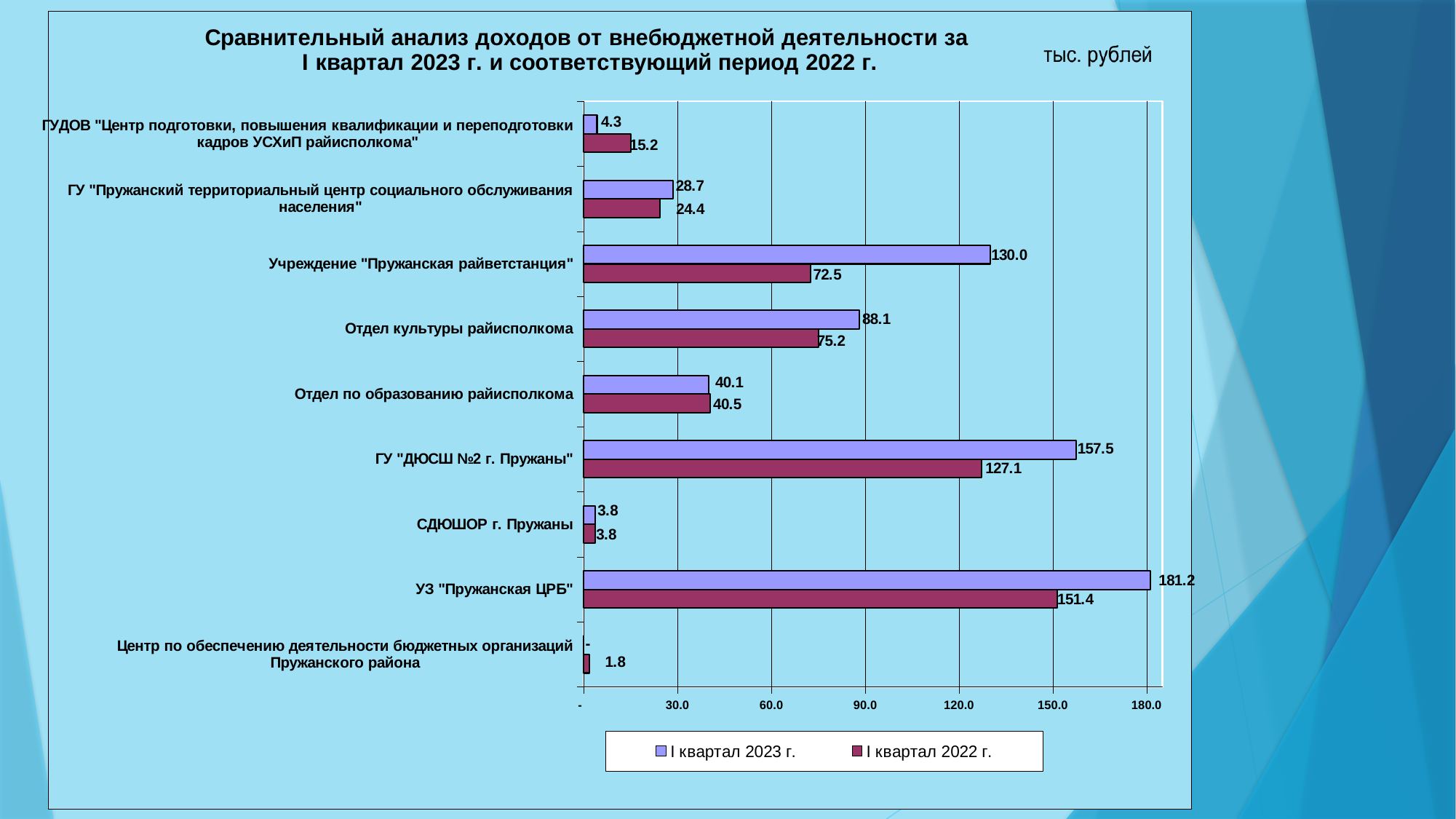
Is the I квартал 2023 г. value for ГУ "ДЮСШ №2 г. Пружаны" greater or less than 150.0? greater What is the value for УЗ "Пружанская ЦРБ" in I квартал 2023 г.? 181.2 What is the difference between the I квартал 2023 г. and I квартал 2022 г. values for Учреждение "Пружанская райветстанция"? 57.5 What type of chart is shown on the slide? bar chart What unit is indicated in the top right corner of the chart? тыс. рублей What is the value for Учреждение "Пружанская райветстанция" in I квартал 2022 г.? 72.5 Which organisation has the highest value in I квартал 2023 г.? УЗ "Пружанская ЦРБ" How many categories (organisations) are plotted on the chart? 9 What is the value for ГУ "ДЮСШ №2 г. Пружаны" in I квартал 2022 г.? 127.1 How many series does the legend list? 2 Which is larger for Отдел культуры райисполкома: the I квартал 2023 г. value or the I квартал 2022 г. value? I квартал 2023 г. Which organisation has the lowest value in I квартал 2022 г.? Центр по обеспечению деятельности бюджетных организаций Пружанского района